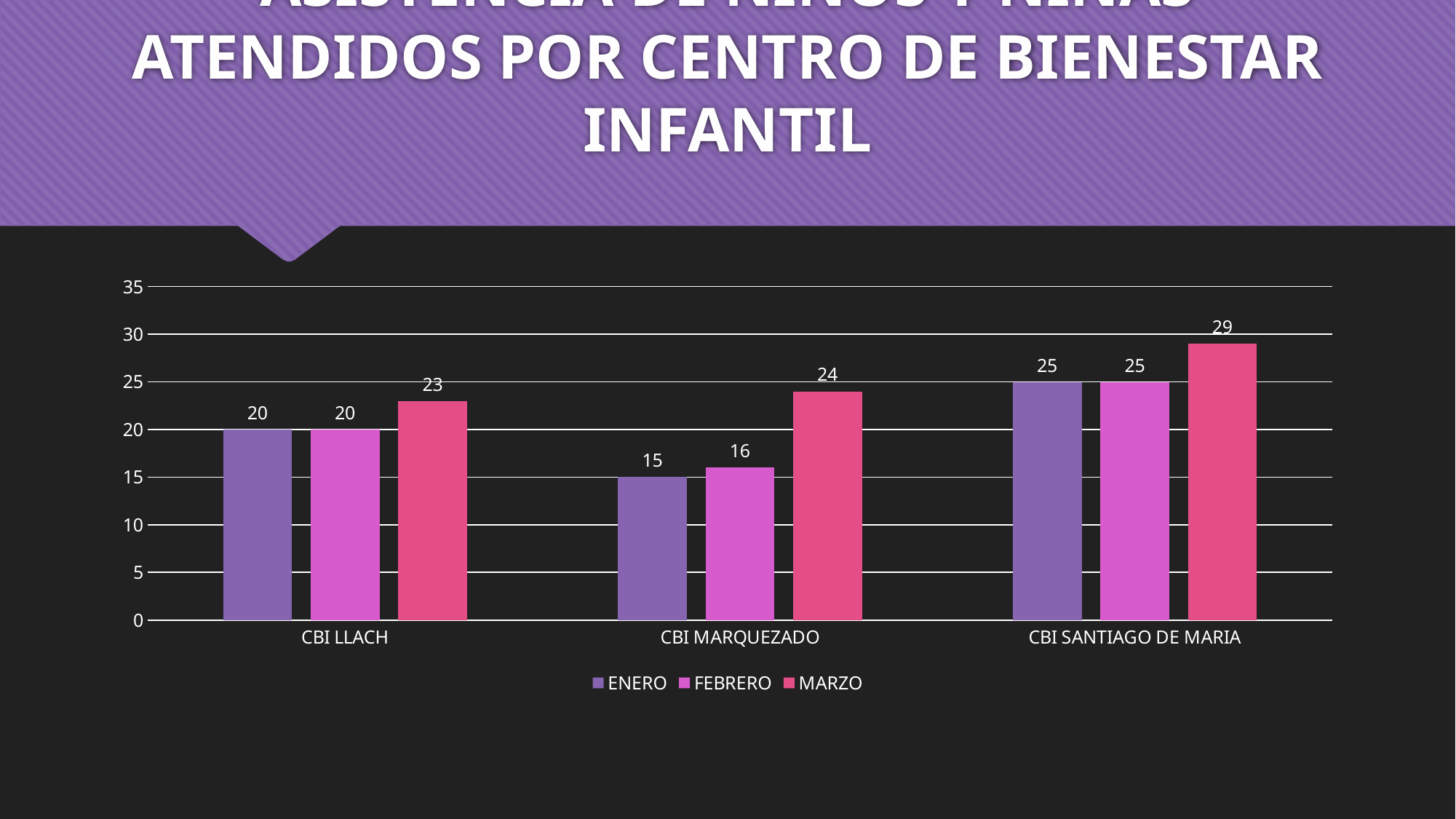
Is the MARZO value for CBI LLACH greater or less than 20? greater Which centre has the lowest ENERO value? CBI MARQUEZADO Which centre has the highest MARZO value? CBI SANTIAGO DE MARIA Which series is shown in the darkest purple colour in the legend? ENERO How many centres are shown on the x axis? 3 Which is larger: the FEBRERO value for CBI LLACH or the FEBRERO value for CBI SANTIAGO DE MARIA? CBI SANTIAGO DE MARIA What is the difference between the MARZO and ENERO values for CBI MARQUEZADO? 9 How many series does the legend list? 3 What kind of chart is shown on the slide? bar chart What is the ENERO value for CBI MARQUEZADO? 15 What is the FEBRERO value for CBI LLACH? 20 What is the MARZO value for CBI SANTIAGO DE MARIA? 29